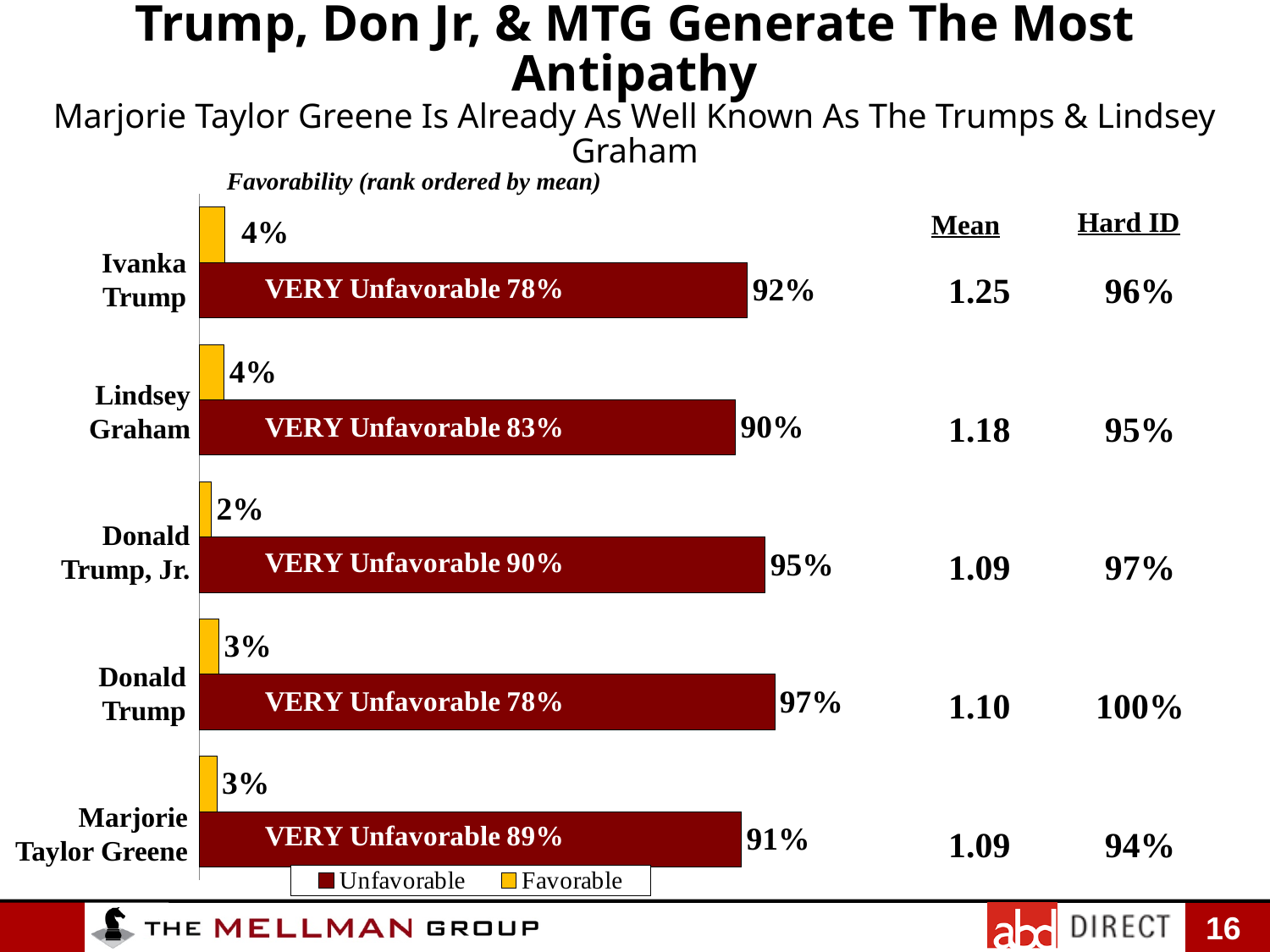
What is the Favorable value for Lindsey Graham? 4% What is the Unfavorable value for Marjorie Taylor Greene? 91% What is the Unfavorable value for Donald Trump? 97% What is the VERY Unfavorable percentage printed on Donald Trump, Jr.'s bar? 90% What is the difference between the Unfavorable values for Donald Trump and Lindsey Graham? 7% How many people are shown in the chart? 5 Which is larger, the Unfavorable value for Ivanka Trump or for Marjorie Taylor Greene? Ivanka Trump What kind of chart is shown on the slide? Bar chart What is the Favorable value for Donald Trump, Jr.? 2% How many series does the legend list? 2 Which person has the lowest Favorable value? Donald Trump, Jr. Which person has the highest Unfavorable value? Donald Trump